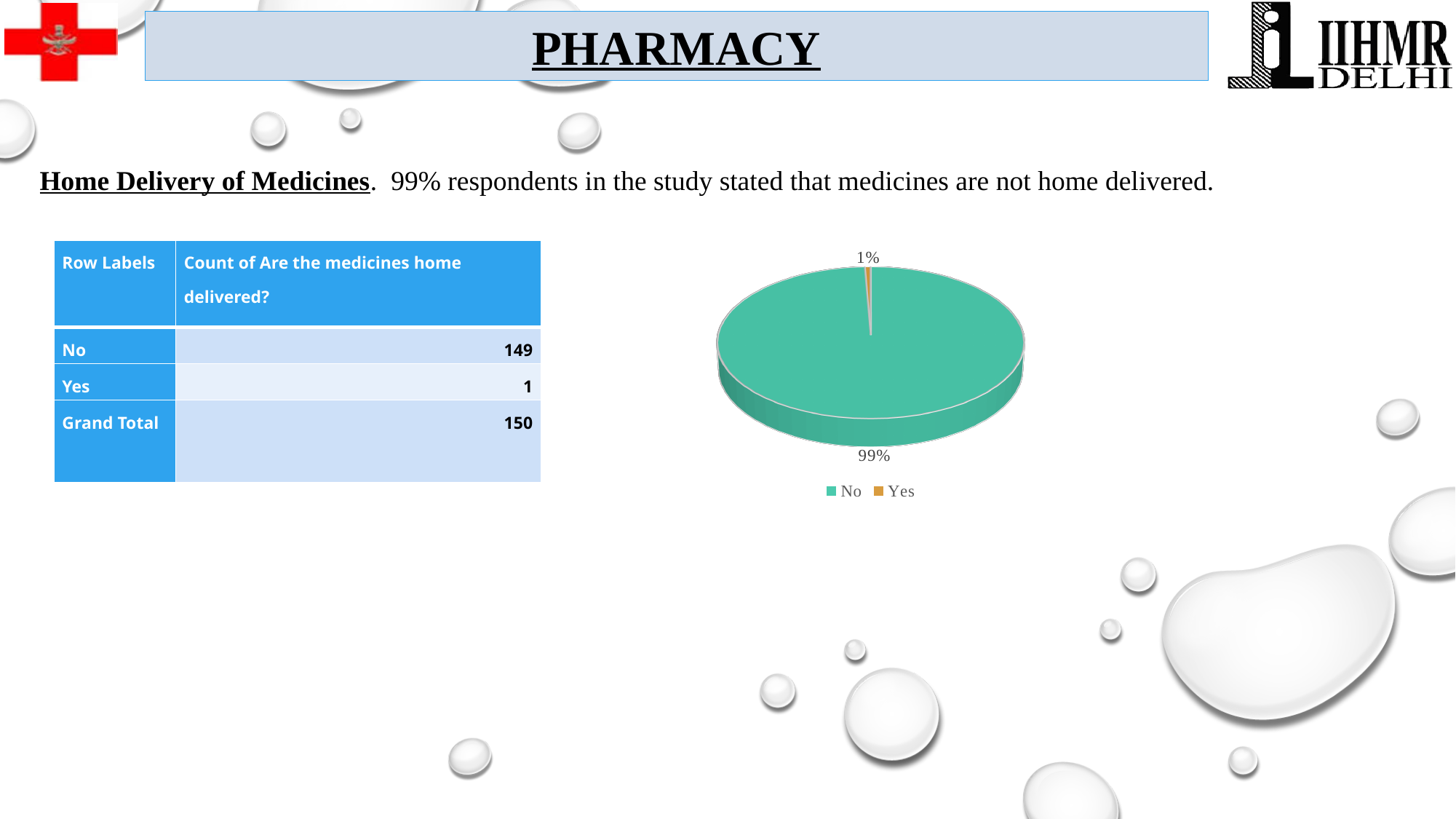
Which slice of the pie chart is the smallest? Yes Which is larger in the pie chart, the 'No' slice or the 'Yes' slice? No How many slices does the pie chart have? 2 What kind of chart is shown on the slide? pie chart How many entries does the pie chart's legend list? 2 What colour is the 'No' slice in the pie chart? green What percentage of the pie chart is labelled for the 'Yes' slice? 1% What colour is the 'Yes' slice in the pie chart? orange What percentage of the pie chart is labelled for the 'No' slice? 99% What is the difference in percentage points between the 'No' slice and the 'Yes' slice in the pie chart? 98% Which slice of the pie chart is the largest? No